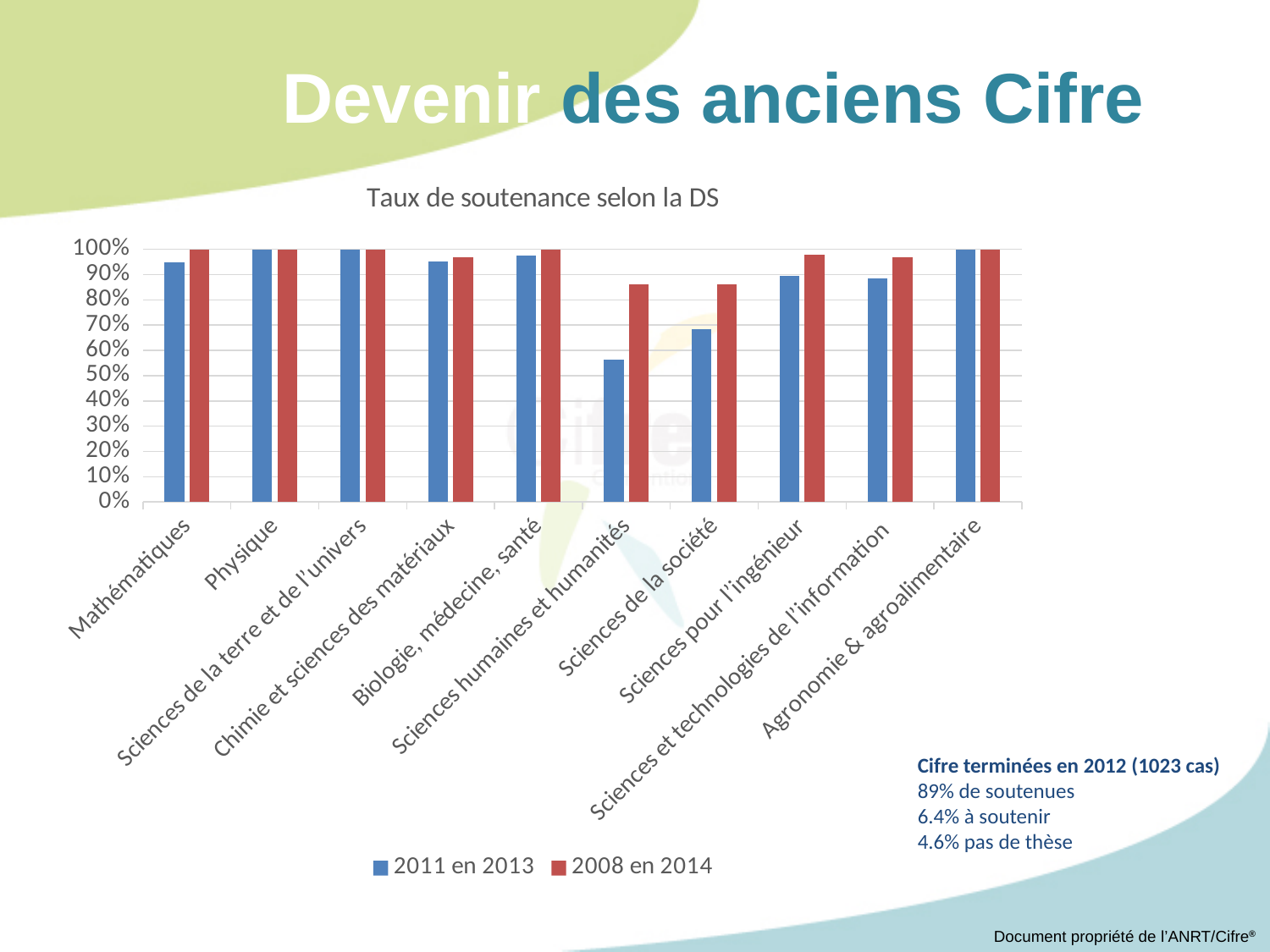
Which discipline has the lowest value for the 2011 en 2013 series? Sciences humaines et humanités What are the two series named in the legend? 2011 en 2013 and 2008 en 2014 For Sciences de la société, which series has the larger value, 2011 en 2013 or 2008 en 2014? 2008 en 2014 What kind of chart is shown on the slide? bar chart What is the 2011 en 2013 value for Physique? 100% How many series does the chart legend list? 2 How many disciplines (categories) are shown on the x axis? 10 Is the 2011 en 2013 value for Sciences de la société greater or less than 60%? greater For Sciences humaines et humanités, which series has the larger value, 2011 en 2013 or 2008 en 2014? 2008 en 2014 What is the title of the chart? Taux de soutenance selon la DS Is the 2008 en 2014 value for Sciences humaines et humanités greater or less than 80%? greater Is the 2011 en 2013 value for Sciences humaines et humanités greater or less than 60%? less